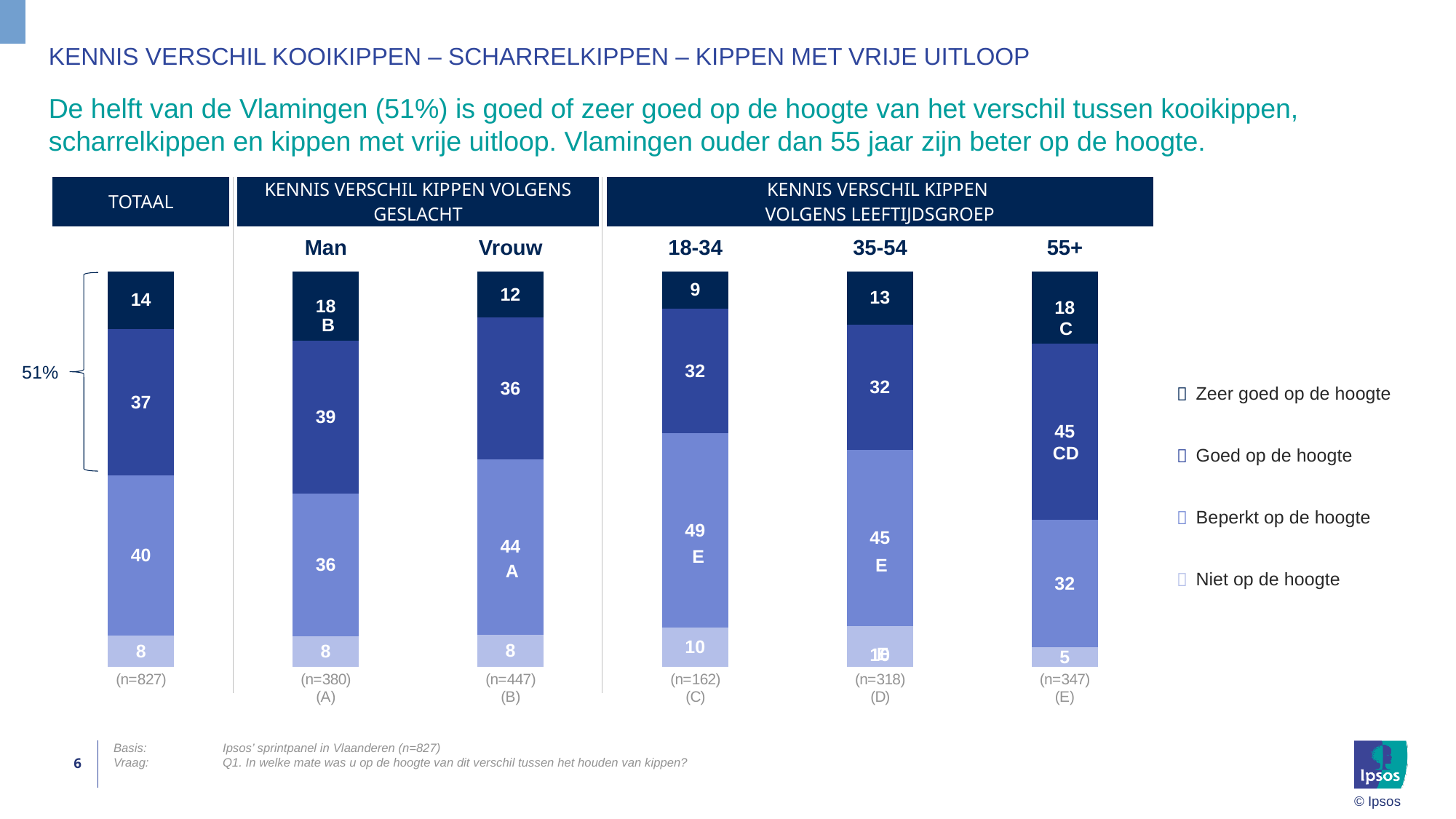
Which is larger, the "Zeer goed op de hoogte" value for Man or for Vrouw? Man What is the value for "Goed op de hoogte" in the 55+ bar? 45 Which age group has the lowest value for "Beperkt op de hoogte"? 55+ What kind of chart is shown on the slide? Stacked bar chart What is the value for "Beperkt op de hoogte" in the Vrouw bar? 44 Which age group has the highest value for "Zeer goed op de hoogte"? 55+ What is the difference between the "Beperkt op de hoogte" values for 18-34 and 55+? 17 What is the value for "Goed op de hoogte" in the Man bar? 39 What is the value for "Niet op de hoogte" in the 18-34 bar? 10 How many series does the legend list? 4 What is the combined value of "Zeer goed op de hoogte" and "Goed op de hoogte" in the TOTAAL bar? 51% What is the value for "Zeer goed op de hoogte" in the TOTAAL bar? 14